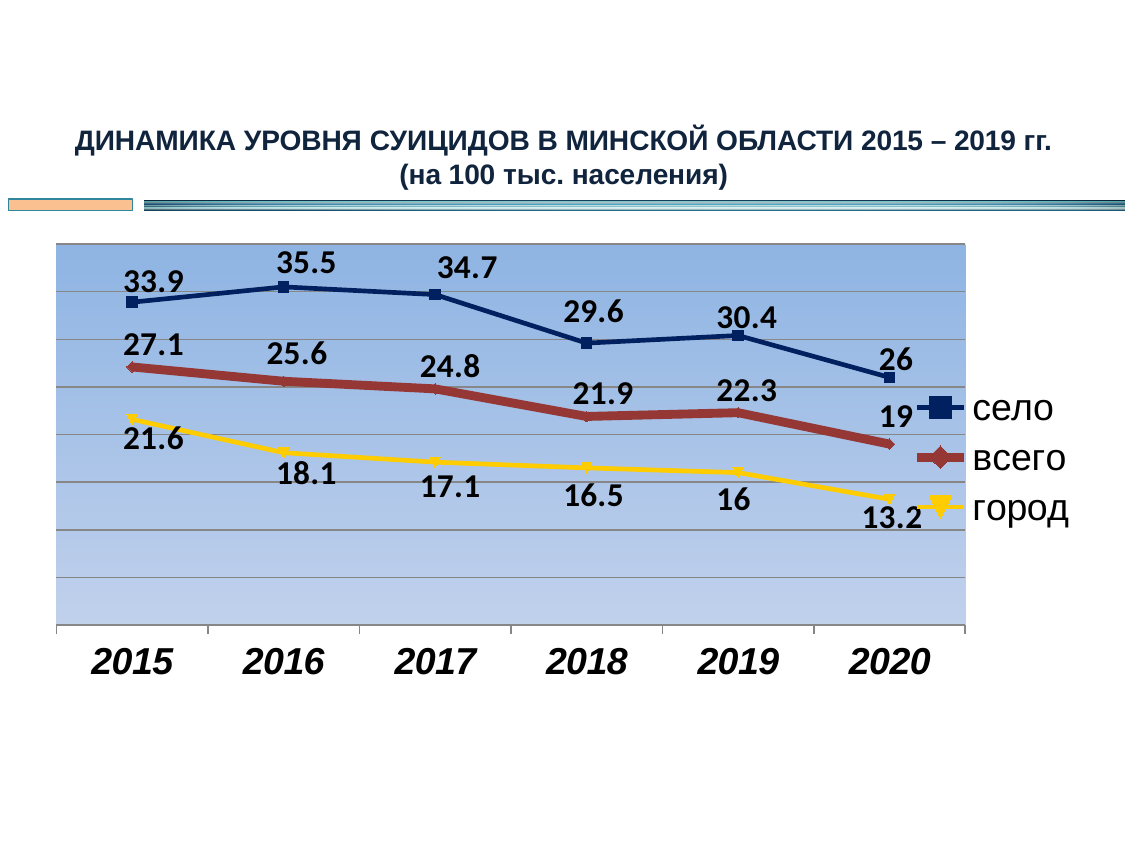
How many series does the legend list? 3 Which is larger: the всего value in 2019 or the всего value in 2018? 2019 In which year is the value for село highest? 2016 What kind of chart is shown on the slide? line chart What is the value for село in 2016? 35.5 Do the values for всего generally rise or fall from 2015 to 2020? fall What is the difference between the село and город values in 2015? 12.3 What is the value for город in 2020? 13.2 Which series is drawn in yellow? город How many years are shown on the x axis? 6 In which year is the value for город lowest? 2020 What is the value for всего in 2018? 21.9